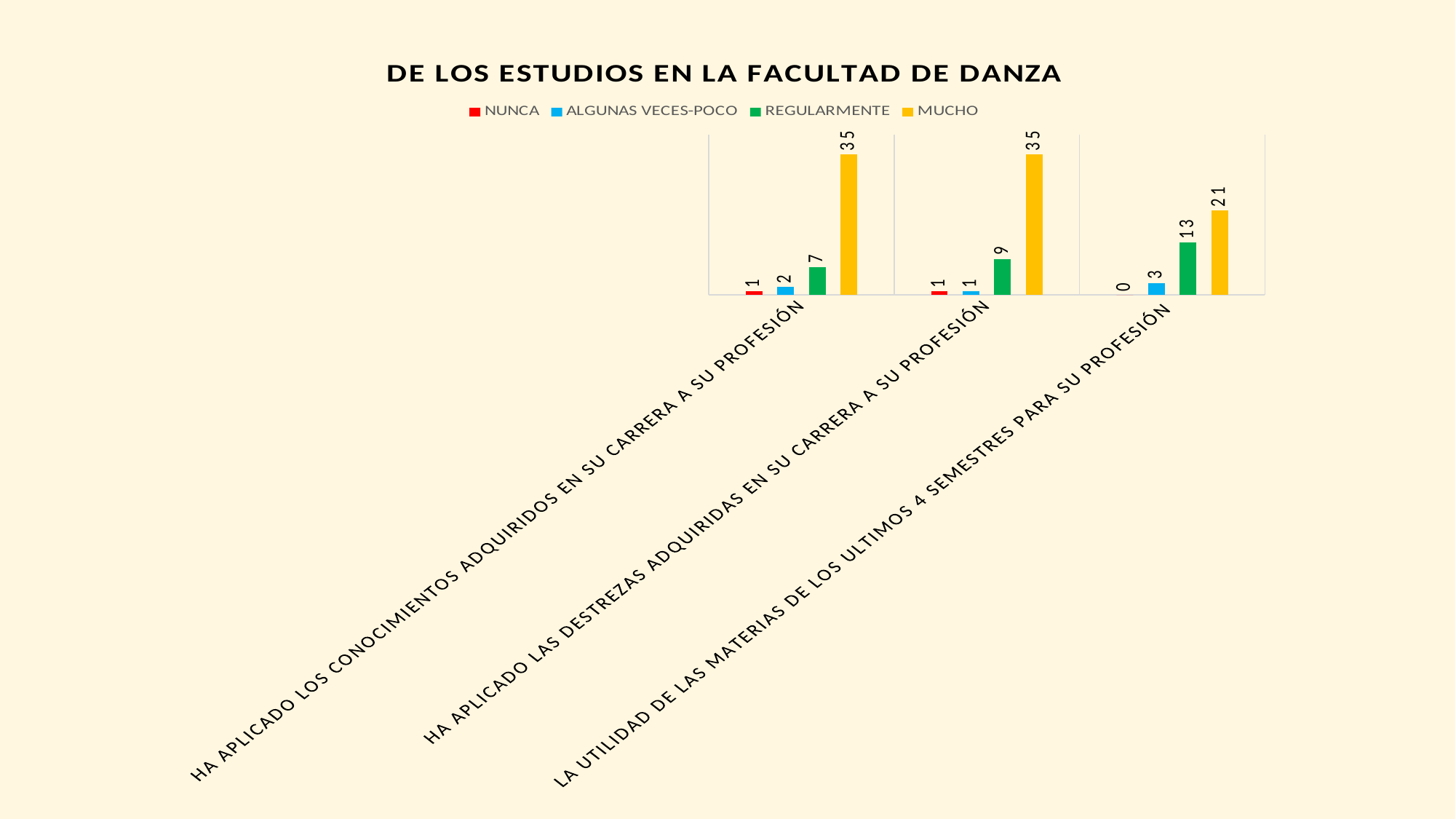
Which category has the lowest MUCHO value? LA UTILIDAD DE LAS MATERIAS DE LOS ULTIMOS 4 SEMESTRES PARA SU PROFESIÓN What is the title of the chart? DE LOS ESTUDIOS EN LA FACULTAD DE DANZA How many series does the legend list? 4 Which is larger for 'HA APLICADO LOS CONOCIMIENTOS ADQUIRIDOS EN SU CARRERA A SU PROFESIÓN': the REGULARMENTE value or the ALGUNAS VECES-POCO value? REGULARMENTE Which category has the highest REGULARMENTE value? LA UTILIDAD DE LAS MATERIAS DE LOS ULTIMOS 4 SEMESTRES PARA SU PROFESIÓN What is the ALGUNAS VECES-POCO value for 'LA UTILIDAD DE LAS MATERIAS DE LOS ULTIMOS 4 SEMESTRES PARA SU PROFESIÓN'? 3 What is the NUNCA value for 'LA UTILIDAD DE LAS MATERIAS DE LOS ULTIMOS 4 SEMESTRES PARA SU PROFESIÓN'? 0 What is the REGULARMENTE value for 'HA APLICADO LAS DESTREZAS ADQUIRIDAS EN SU CARRERA A SU PROFESIÓN'? 9 How many categories are shown on the x axis? 3 What is the MUCHO value for 'HA APLICADO LOS CONOCIMIENTOS ADQUIRIDOS EN SU CARRERA A SU PROFESIÓN'? 35 What is the difference between the MUCHO and REGULARMENTE values for 'LA UTILIDAD DE LAS MATERIAS DE LOS ULTIMOS 4 SEMESTRES PARA SU PROFESIÓN'? 8 What type of chart is shown on the slide? Bar chart